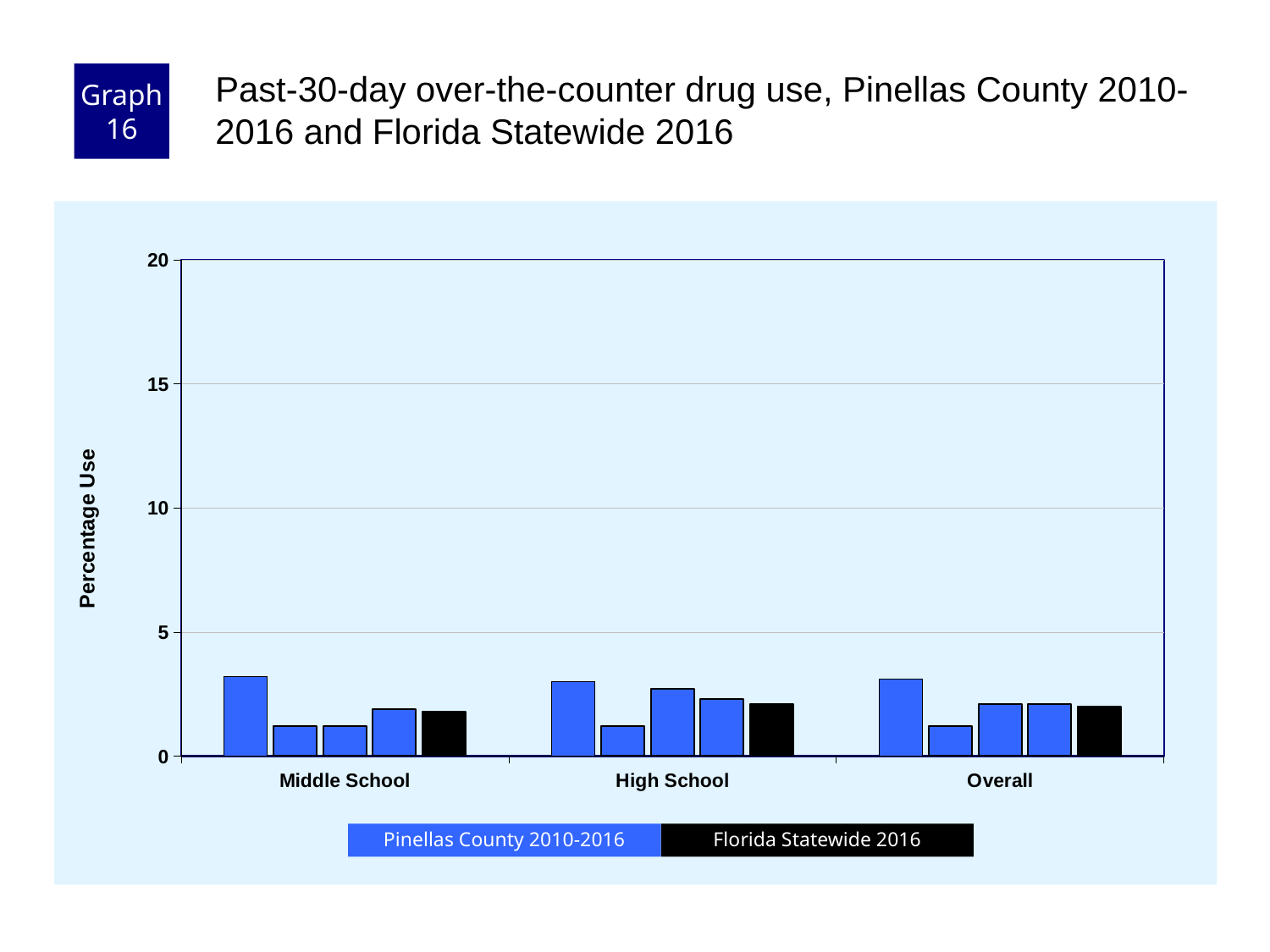
Which colour represents Florida Statewide 2016 in the legend? black What is the label of the y axis? Percentage Use Are any of the bars in the chart greater than 10? no For Middle School, which is larger: the first (leftmost) Pinellas County bar or the Florida Statewide 2016 bar? the first Pinellas County bar Is the Florida Statewide 2016 value for High School greater or less than 5? less What kind of chart is shown on the slide? bar chart What is the maximum value shown on the y axis? 20 How many categories are shown along the x axis? 3 How many series does the legend list? 2 Is the Florida Statewide 2016 value for Overall greater or less than 5? less For High School, which is larger: the first (leftmost) Pinellas County bar or the Florida Statewide 2016 bar? the first Pinellas County bar